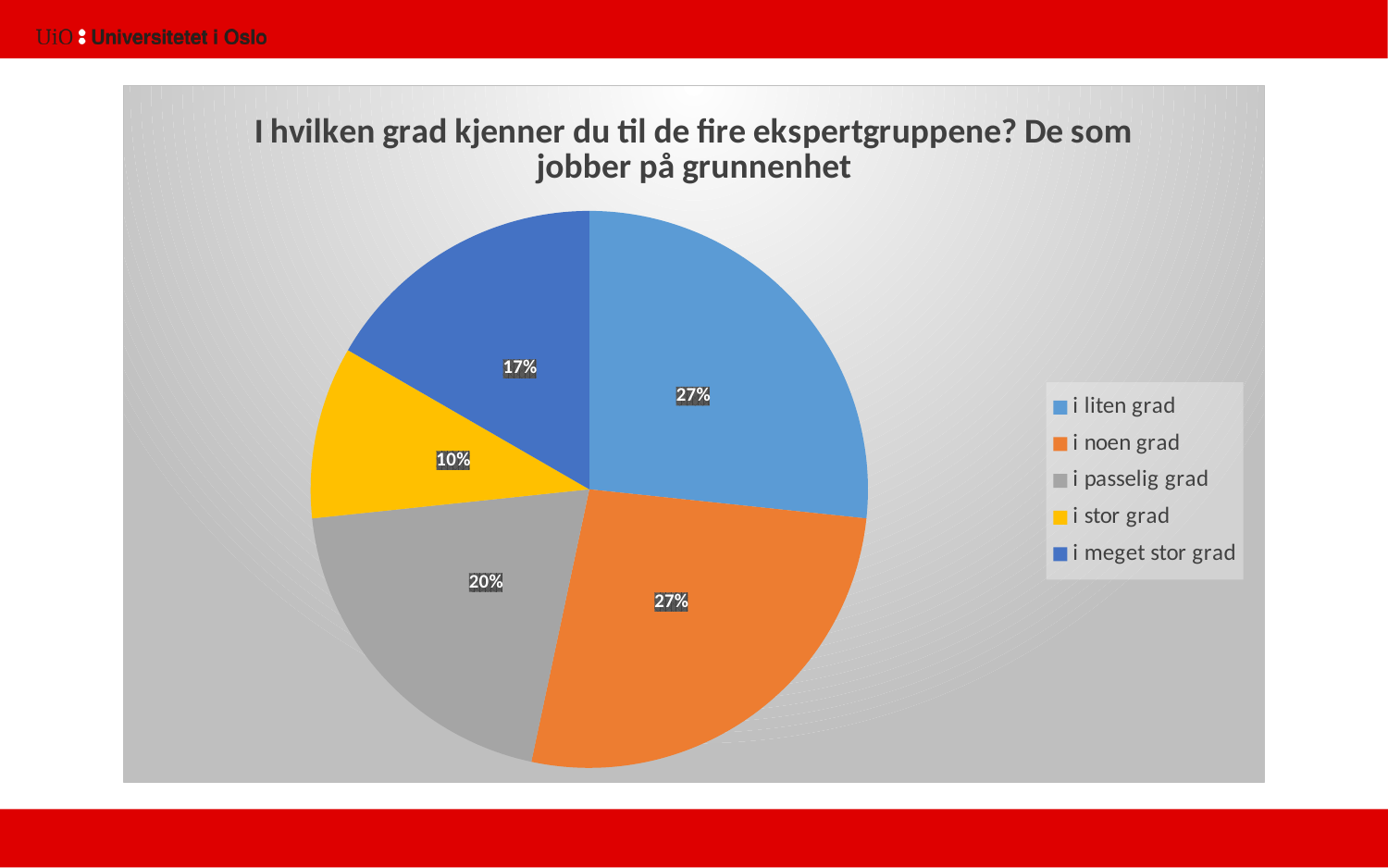
What share of the pie does "i liten grad" have? 27% Which colour represents "i stor grad" in the legend? yellow What share of the pie does "i stor grad" have? 10% Which is larger, the slice for "i meget stor grad" or the slice for "i stor grad"? i meget stor grad How many categories does the pie chart show? 5 What share of the pie does "i noen grad" have? 27% Which category has the smallest slice of the pie? i stor grad What is the difference in percentage points between "i passelig grad" and "i stor grad"? 10 What is the difference in percentage points between "i liten grad" and "i meget stor grad"? 10 What kind of chart is shown on the slide? pie chart